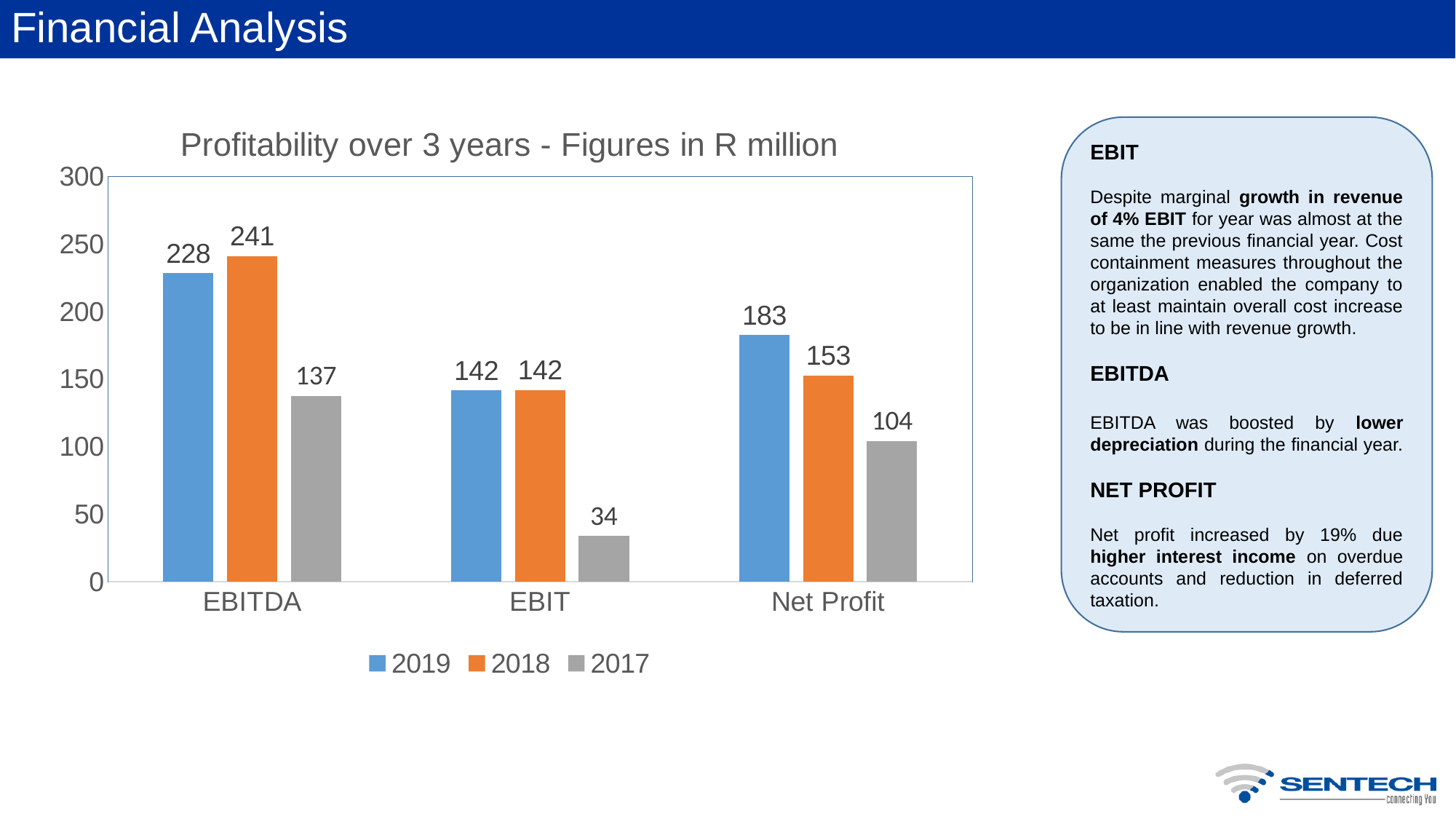
What is the EBITDA value for 2019? 228 Which category has the lowest value for 2017? EBIT What is the difference between the 2018 and 2017 EBITDA values? 104 What is the difference between the 2019 and 2018 Net Profit values? 30 What is the title of the chart? Profitability over 3 years - Figures in R million What is the Net Profit value for 2017? 104 Which category has the highest value for 2018? EBITDA How many categories are shown on the x axis? 3 What is the EBIT value for 2018? 142 What kind of chart is shown on the slide? Bar chart How many series does the legend list? 3 Which is larger, the 2019 Net Profit or the 2018 Net Profit? 2019 Net Profit